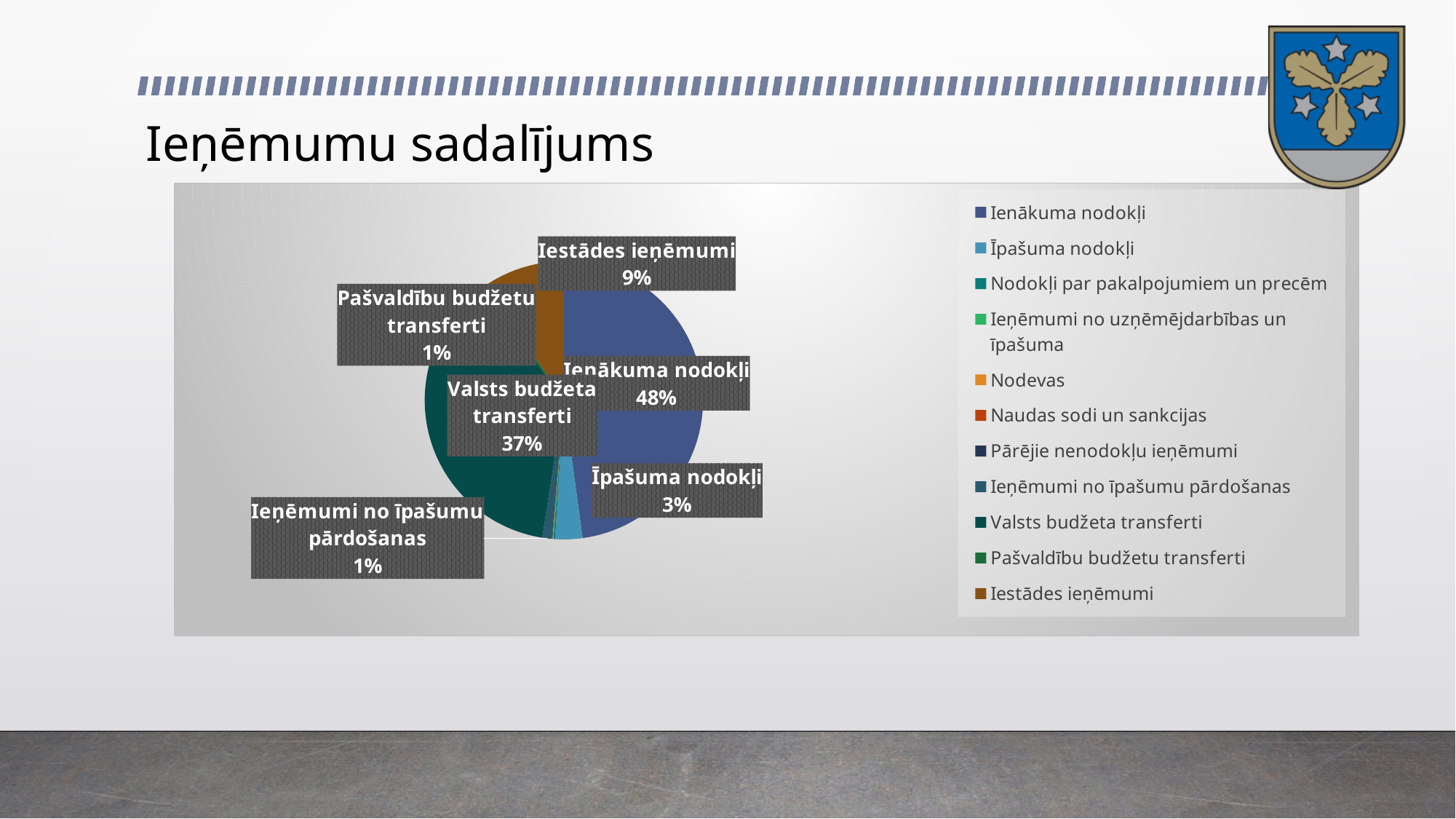
What share of the pie does Iestādes ieņēmumi have? 9% What is the difference in percentage points between Ienākuma nodokļi and Valsts budžeta transferti? 11 Which is larger, Valsts budžeta transferti or Iestādes ieņēmumi? Valsts budžeta transferti What is the title of the slide above the chart? Ieņēmumu sadalījums What share of the pie does Ienākuma nodokļi have? 48% What share of the pie does Ieņēmumi no īpašumu pārdošanas have? 1% What kind of chart is shown on the slide? pie chart What share of the pie does Valsts budžeta transferti have? 37% Which category has the largest share of the pie? Ienākuma nodokļi What share of the pie does Pašvaldību budžetu transferti have? 1% How many entries does the legend list? 11 What share of the pie does Īpašuma nodokļi have? 3%